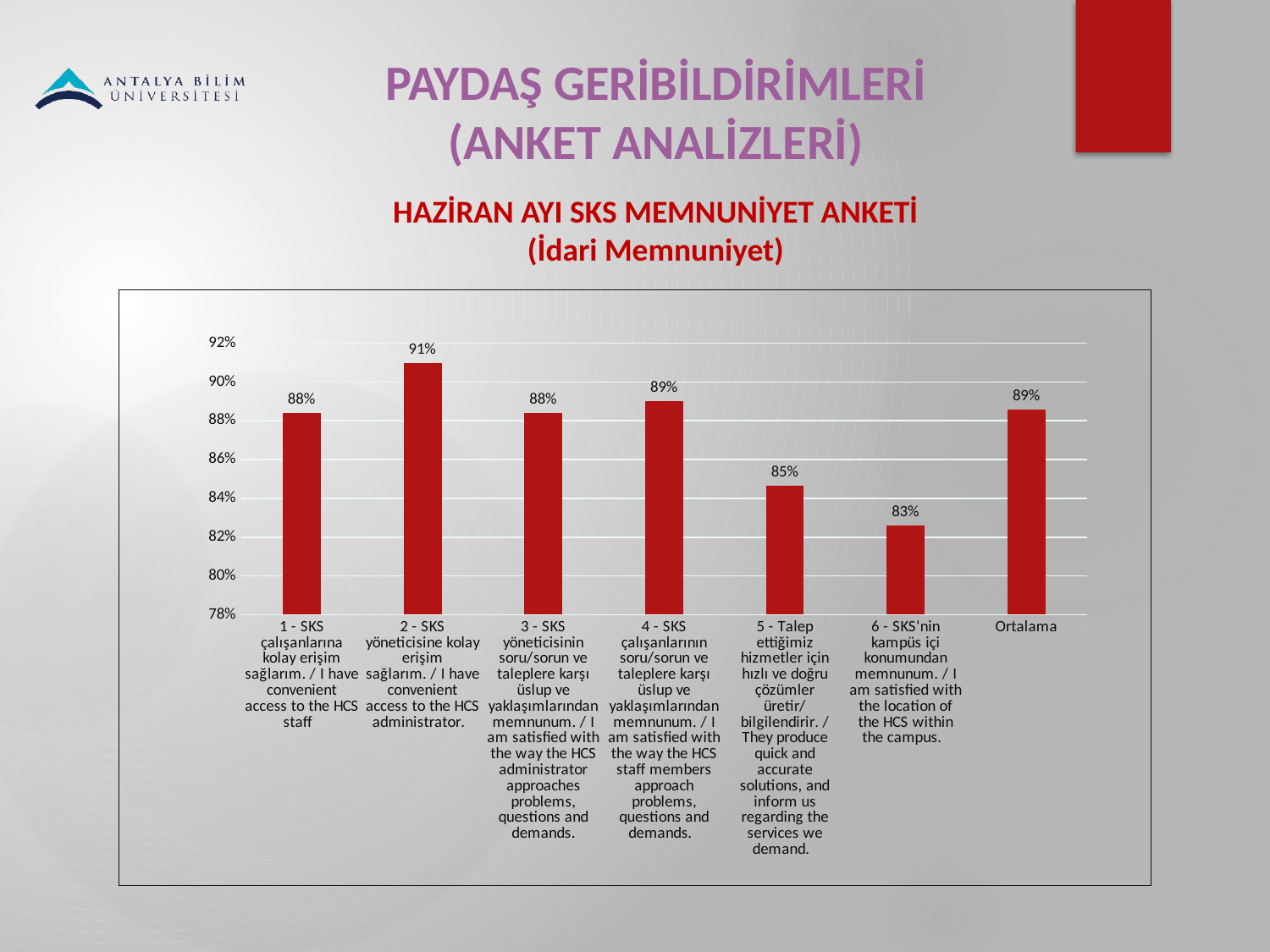
What is the subtitle of the chart shown in red below the main title? HAZİRAN AYI SKS MEMNUNİYET ANKETİ (İdari Memnuniyet) What is the value for the Ortalama category? 89% What is the value for category 5 - Talep ettiğimiz hizmetler için hızlı ve doğru çözümler üretir? 85% Which category has the lowest value? 6 - SKS'nin kampüs içi konumundan memnunum What is the difference between the highest value (category 2) and the lowest value (category 6)? 8 percentage points Is the value for category 6 - SKS'nin kampüs içi konumundan memnunum greater or less than 84%? less Which category has the highest value? 2 - SKS yöneticisine kolay erişim sağlarım What is the value for category 6 - SKS'nin kampüs içi konumundan memnunum? 83% How many categories (bars) are shown in the chart? 7 What is the value for category 2 - SKS yöneticisine kolay erişim sağlarım? 91% What kind of chart is shown on the slide? bar chart Which is larger, the value for category 5 - Talep ettiğimiz hizmetler or the value for category 6 - SKS'nin kampüs içi konumundan memnunum? 5 - Talep ettiğimiz hizmetler